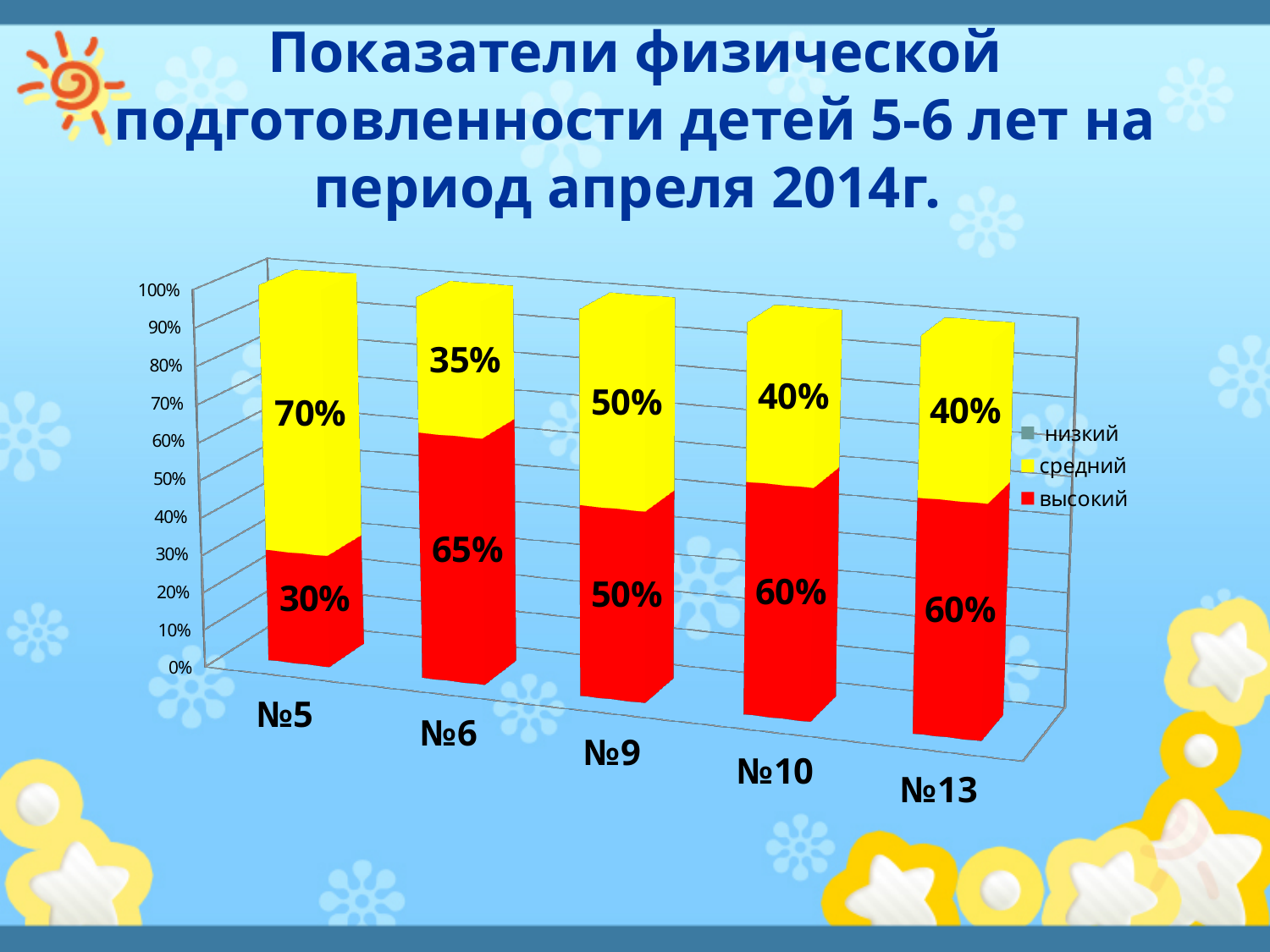
Which category has the lowest value for the высокий series? №5 What is the value of the средний series for №5? 70% How many series does the legend list? 3 Which is larger for №13: the средний value or the высокий value? высокий Which colour represents the высокий series in the legend? Red Which category has the highest value for the высокий series? №6 Which is larger for №9: the средний value or the высокий value? They are equal (50%) What kind of chart is shown on the slide? Stacked bar chart What is the difference between the средний and высокий values for №5? 40% What is the value of the высокий series for №6? 65% What is the value of the высокий series for №10? 60% How many categories are shown on the x axis? 5